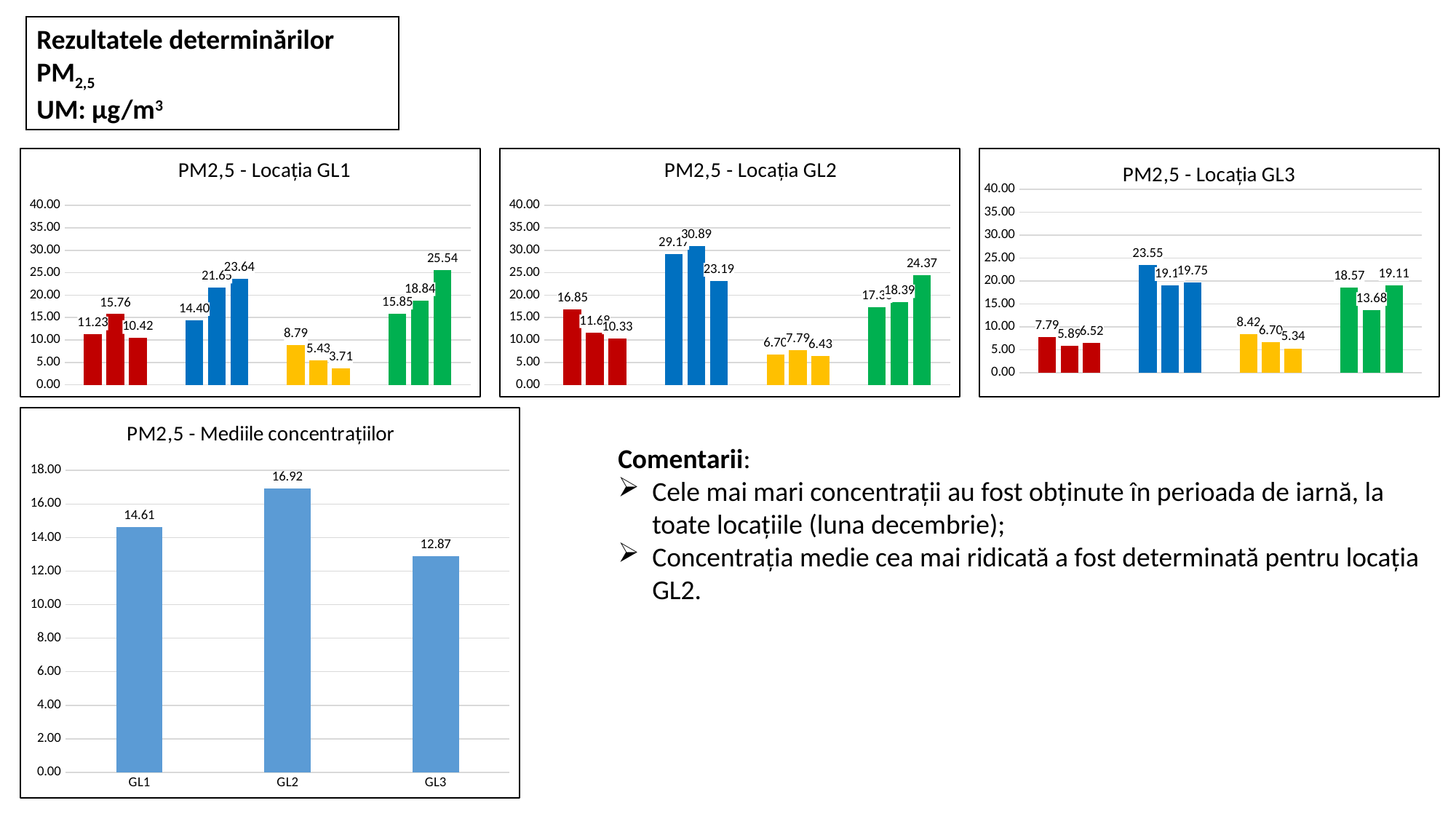
In the 'PM2,5 - Locația GL1' chart, what is the highest value shown? 25.54 In the 'PM2,5 - Mediile concentrațiilor' chart, how many locations are shown? 3 In the 'PM2,5 - Mediile concentrațiilor' chart, what is the value for GL2? 16.92 In the 'PM2,5 - Mediile concentrațiilor' chart, which location has the lowest value? GL3 In the 'PM2,5 - Locația GL2' chart, what is the highest value shown? 30.89 In the 'PM2,5 - Mediile concentrațiilor' chart, what is the value for GL3? 12.87 In the 'PM2,5 - Mediile concentrațiilor' chart, which location has the highest value? GL2 In the 'PM2,5 - Locația GL3' chart, what is the lowest value shown? 5.34 In the 'PM2,5 - Mediile concentrațiilor' chart, what is the difference between the values for GL2 and GL1? 2.31 What kind of chart is 'PM2,5 - Mediile concentrațiilor'? Bar chart In the 'PM2,5 - Locația GL1' chart, what is the lowest value shown? 3.71 In the 'PM2,5 - Mediile concentrațiilor' chart, is the value for GL1 greater or less than 14.00? greater